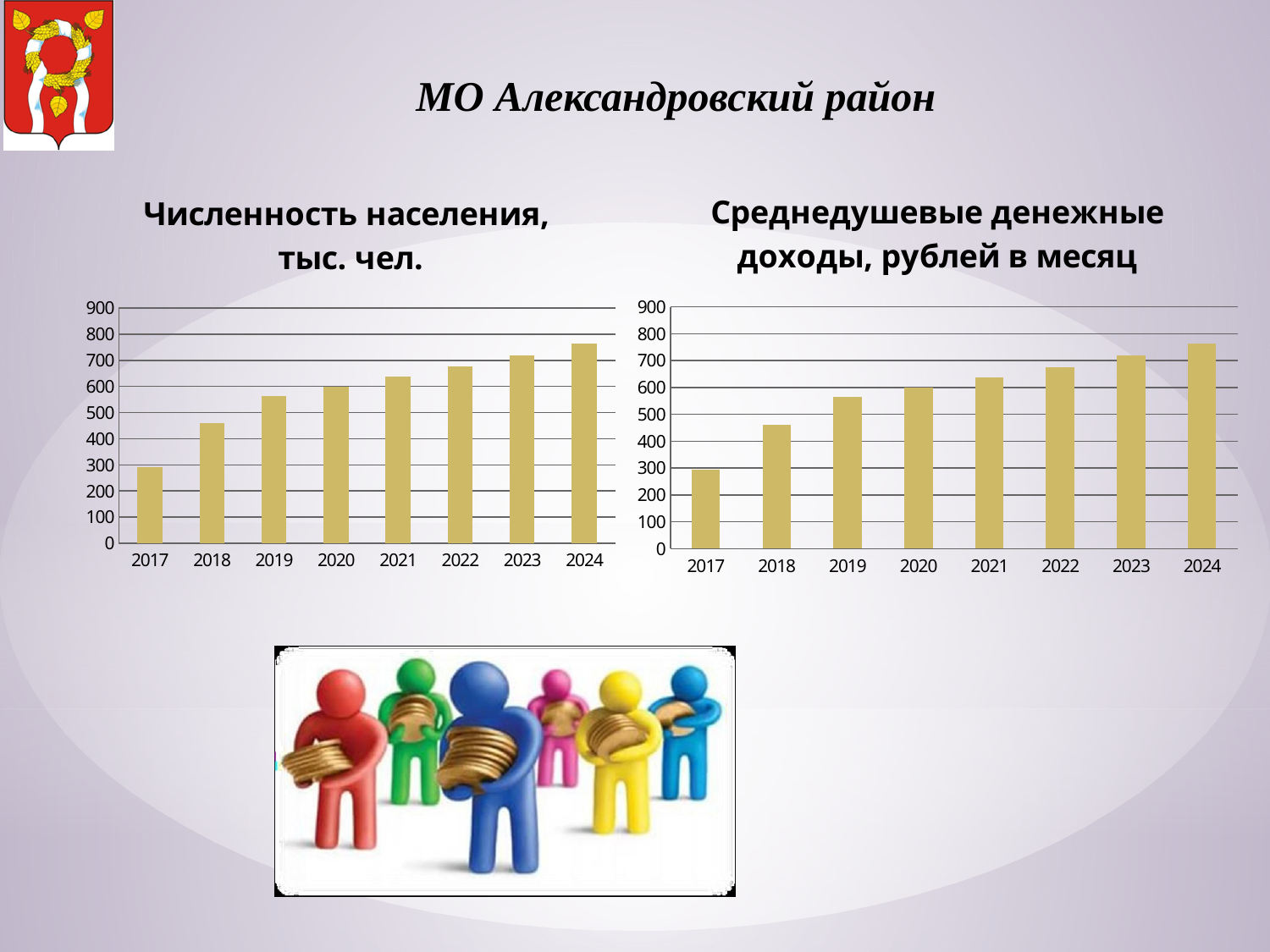
In the 'Среднедушевые денежные доходы, рублей в месяц' chart, is the value for 2018 greater or less than 500? less In the 'Численность населения, тыс. чел.' chart, which year has the lowest value? 2017 How many years are shown on the x axis of the 'Среднедушевые денежные доходы, рублей в месяц' chart? 8 What is the highest value shown on the y axis of the 'Среднедушевые денежные доходы, рублей в месяц' chart? 900 What kind of chart is the 'Численность населения, тыс. чел.' chart? bar chart In the 'Среднедушевые денежные доходы, рублей в месяц' chart, which is larger, the value for 2021 or the value for 2018? 2021 What is the title of the chart on the left side of the slide? Численность населения, тыс. чел. In the 'Численность населения, тыс. чел.' chart, is the value for 2024 greater or less than 700? greater In the 'Среднедушевые денежные доходы, рублей в месяц' chart, do the values rise or fall from 2017 to 2024? rise In the 'Среднедушевые денежные доходы, рублей в месяц' chart, is the value for 2019 greater or less than 500? greater In the 'Численность населения, тыс. чел.' chart, which year has the highest value? 2024